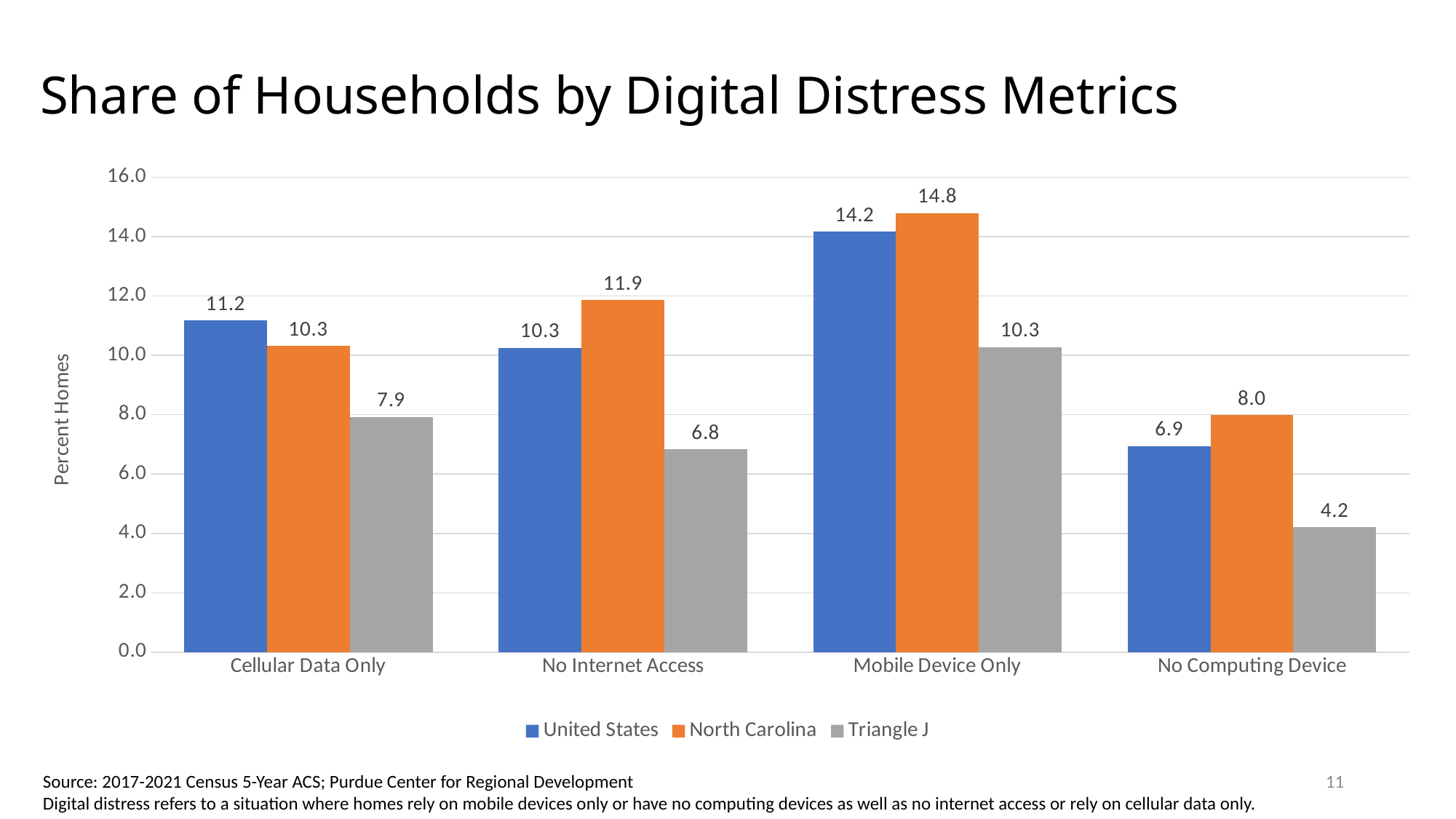
What is the label of the y axis? Percent Homes Which category has the highest value for Triangle J? Mobile Device Only In the Cellular Data Only category, which is larger: the United States value or the North Carolina value? United States How many series does the legend list? 3 What is the difference between the North Carolina and Triangle J values in the No Internet Access category? 5.1 What is the value for the United States in the Cellular Data Only category? 11.2 What kind of chart is shown on the slide? bar chart How many categories are shown on the x axis? 4 Is the value for Triangle J in the Mobile Device Only category greater or less than 12.0? less Which category has the lowest value for the United States? No Computing Device What is the value for North Carolina in the Mobile Device Only category? 14.8 What is the value for Triangle J in the No Computing Device category? 4.2